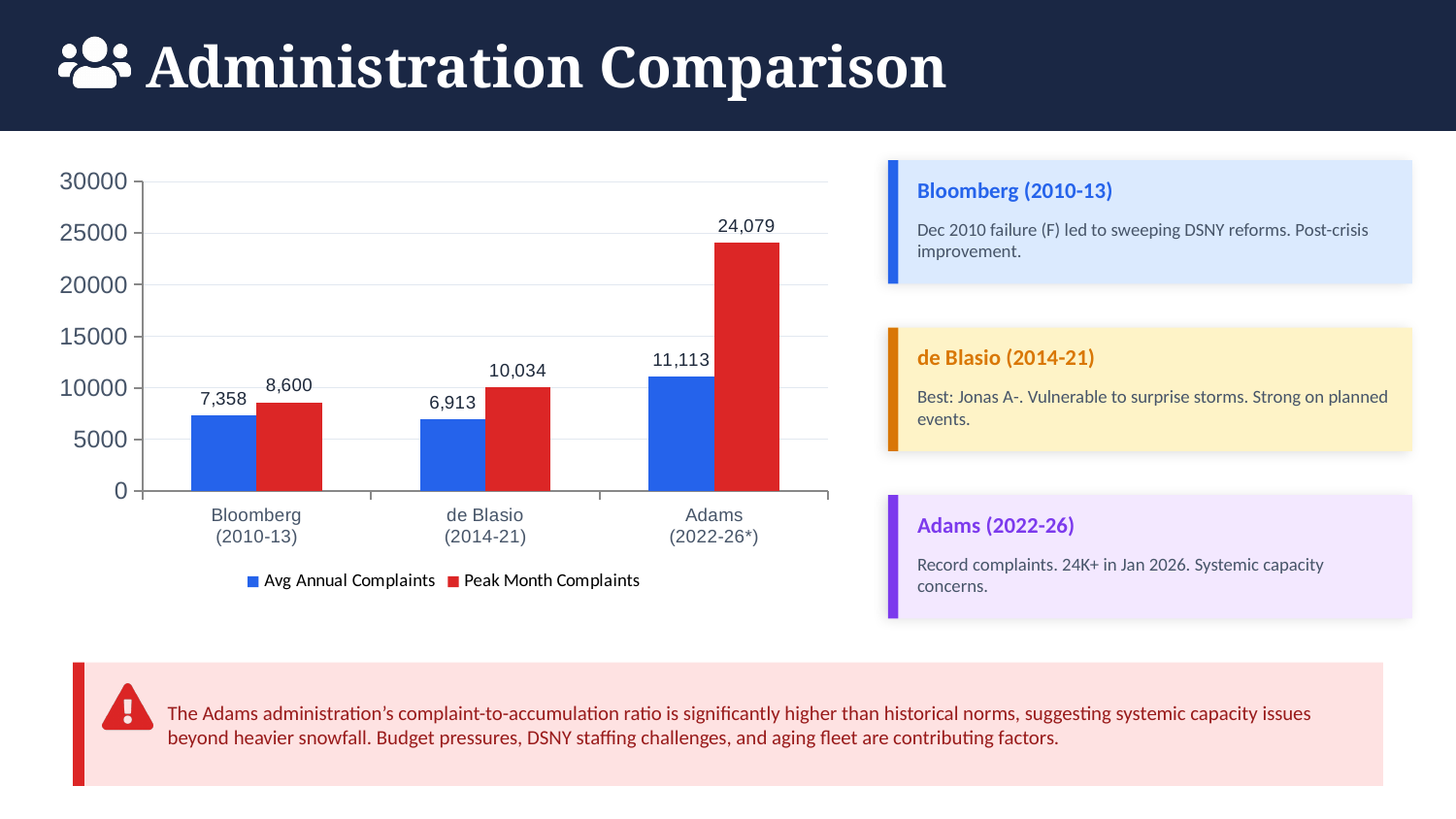
What kind of chart is shown on the slide? Bar chart What is the Peak Month Complaints value for Adams (2022-26*)? 24,079 How many series does the chart legend list? 2 How many administrations are shown on the x axis of the chart? 3 What is the Peak Month Complaints value for de Blasio (2014-21)? 10,034 Which administration has the highest Peak Month Complaints? Adams (2022-26*) Which administration has the lowest Avg Annual Complaints? de Blasio (2014-21) Is the Peak Month Complaints value for Adams (2022-26*) greater or less than 20000? greater What is the Avg Annual Complaints value for Bloomberg (2010-13)? 7,358 What is the difference between Peak Month Complaints and Avg Annual Complaints for Adams (2022-26*)? 12,966 What is the difference in Avg Annual Complaints between Adams (2022-26*) and Bloomberg (2010-13)? 3,755 Which is larger: Peak Month Complaints for Bloomberg (2010-13) or Peak Month Complaints for de Blasio (2014-21)? de Blasio (2014-21)